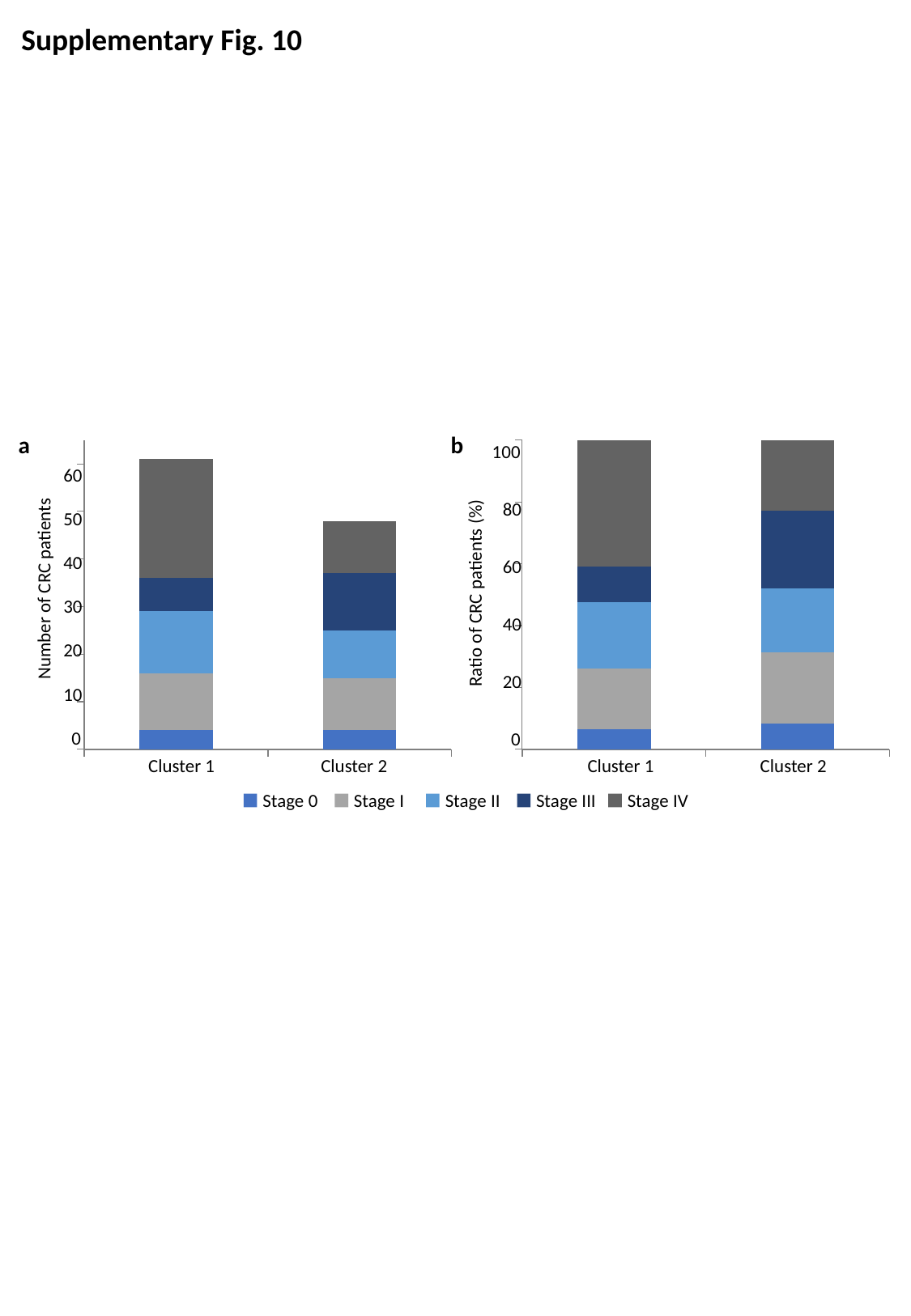
What kind of chart is chart a (Number of CRC patients)? Stacked bar chart What is the y-axis label of chart b? Ratio of CRC patients (%) In chart b (Ratio of CRC patients), is the Stage III share larger for Cluster 1 or Cluster 2? Cluster 2 Which legend entry is shown in dark grey? Stage IV In chart b, which stage forms the largest segment of the Cluster 1 bar? Stage IV In chart a, is the total number of CRC patients for Cluster 1 greater or less than 50? greater In chart b, is the Stage IV share for Cluster 2 greater or less than 40%? less How many series does the legend list? 5 In chart b (Ratio of CRC patients), is the Stage IV share larger for Cluster 1 or Cluster 2? Cluster 1 In chart a (Number of CRC patients), which cluster has the taller stacked bar? Cluster 1 In chart a, is the total number of CRC patients for Cluster 2 greater or less than 60? less How many clusters are shown on the x axis of chart a? 2